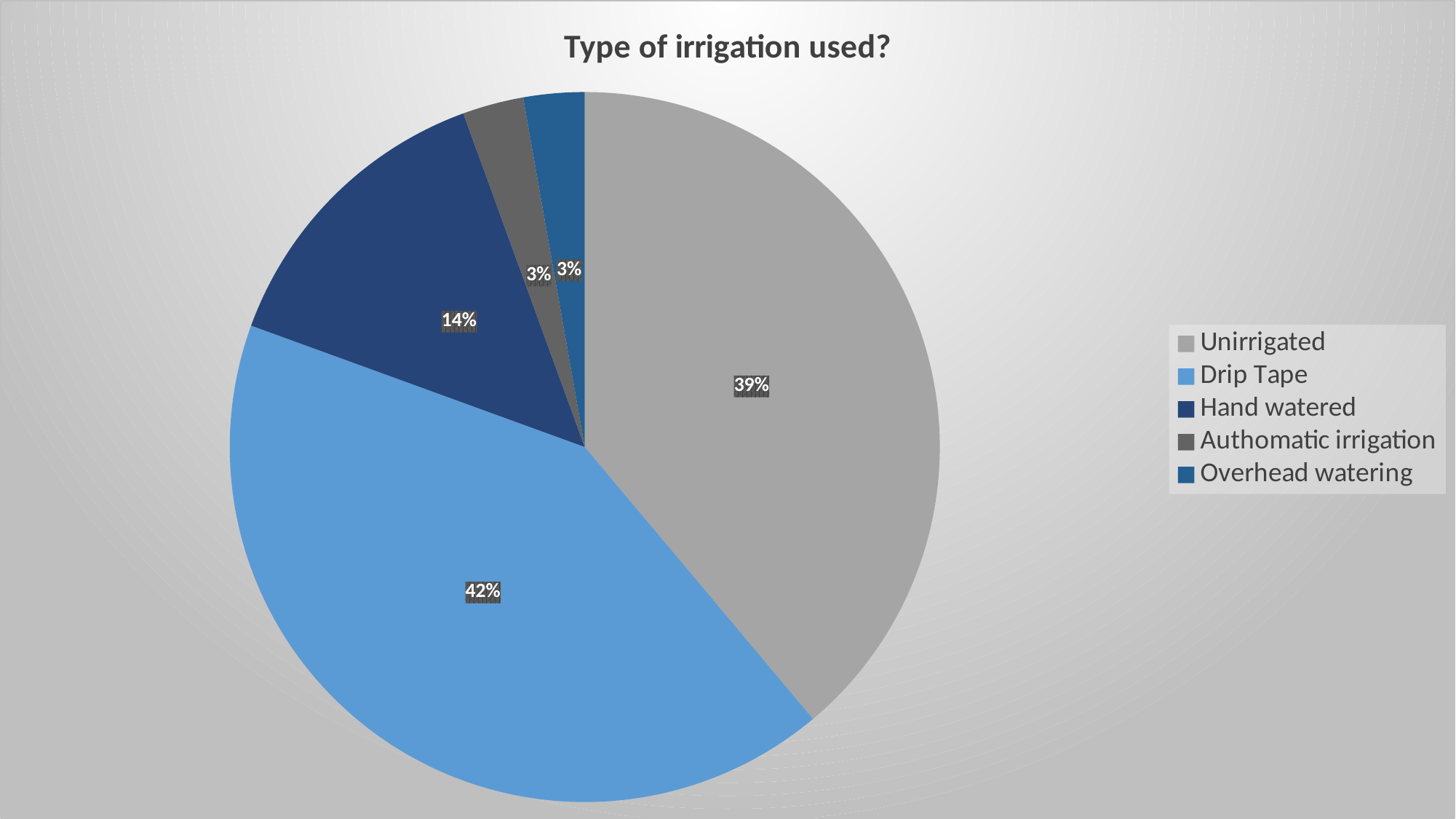
What type of chart is shown on the slide? pie chart How many categories does the legend list? 5 Which is larger, the Hand watered slice or the Authomatic irrigation slice? Hand watered What share of the pie is Hand watered? 14% What is the combined share of Drip Tape and Unirrigated? 81% What share of the pie is Drip Tape? 42% What is the difference between the Drip Tape and Unirrigated shares? 3% Which legend entry is shown in light grey? Unirrigated Which category has the largest slice of the pie? Drip Tape What is the title of the chart? Type of irrigation used? What share of the pie is Overhead watering? 3% What share of the pie is Unirrigated? 39%